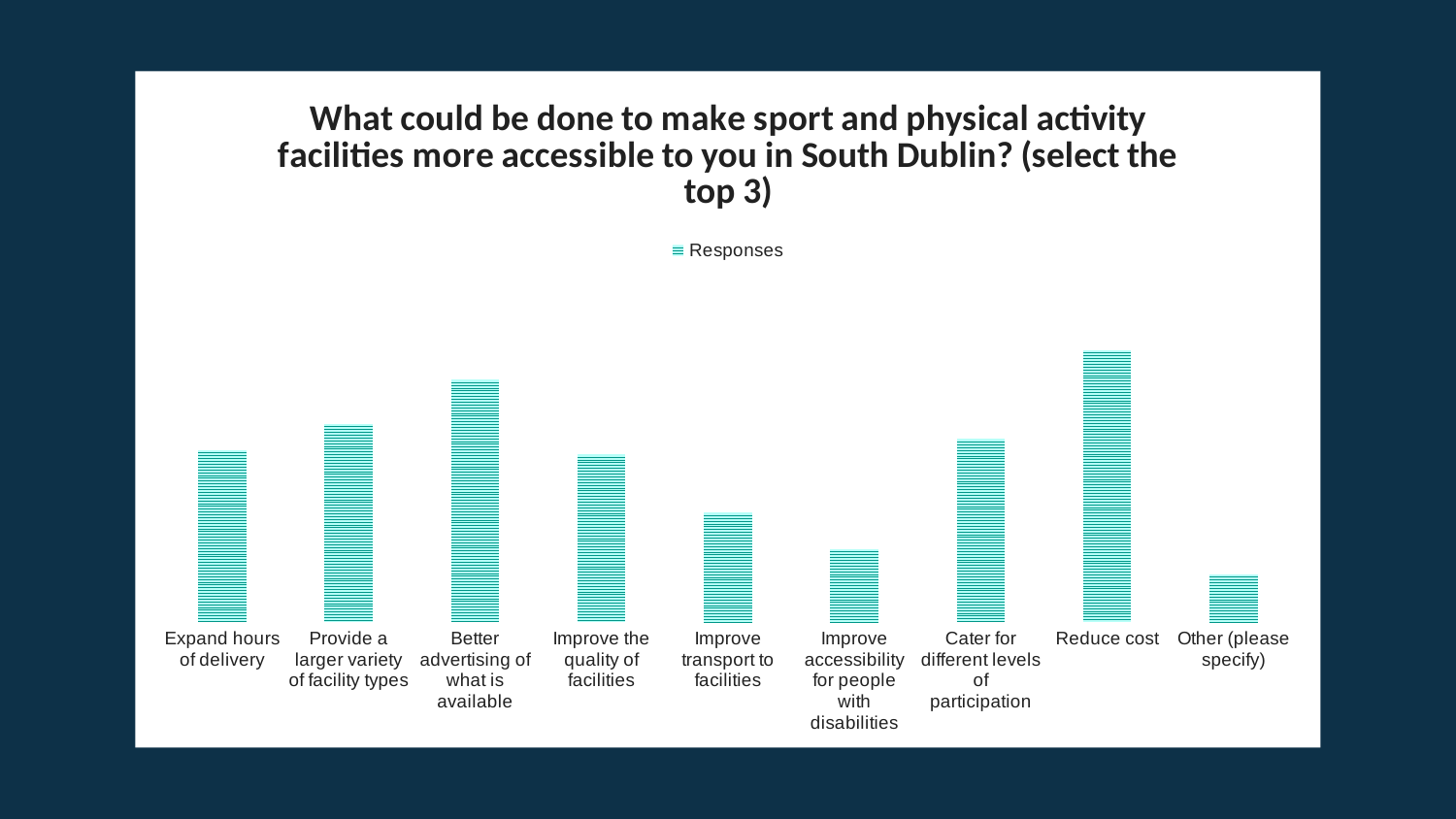
What kind of chart is shown on the slide? bar chart What is the title of the chart? What could be done to make sport and physical activity facilities more accessible to you in South Dublin? (select the top 3) Which category has the lowest number of responses? Other (please specify) How many series does the chart's legend list? 1 Which has more responses: 'Better advertising of what is available' or 'Improve transport to facilities'? Better advertising of what is available Which has more responses: 'Improve transport to facilities' or 'Improve accessibility for people with disabilities'? Improve transport to facilities Which category has the second-highest number of responses? Better advertising of what is available How many categories are shown on the x axis of the chart? 9 Which category has the highest number of responses? Reduce cost What is the name of the series shown in the chart's legend? Responses Which has more responses: 'Reduce cost' or 'Better advertising of what is available'? Reduce cost Which category has the second-lowest number of responses? Improve accessibility for people with disabilities